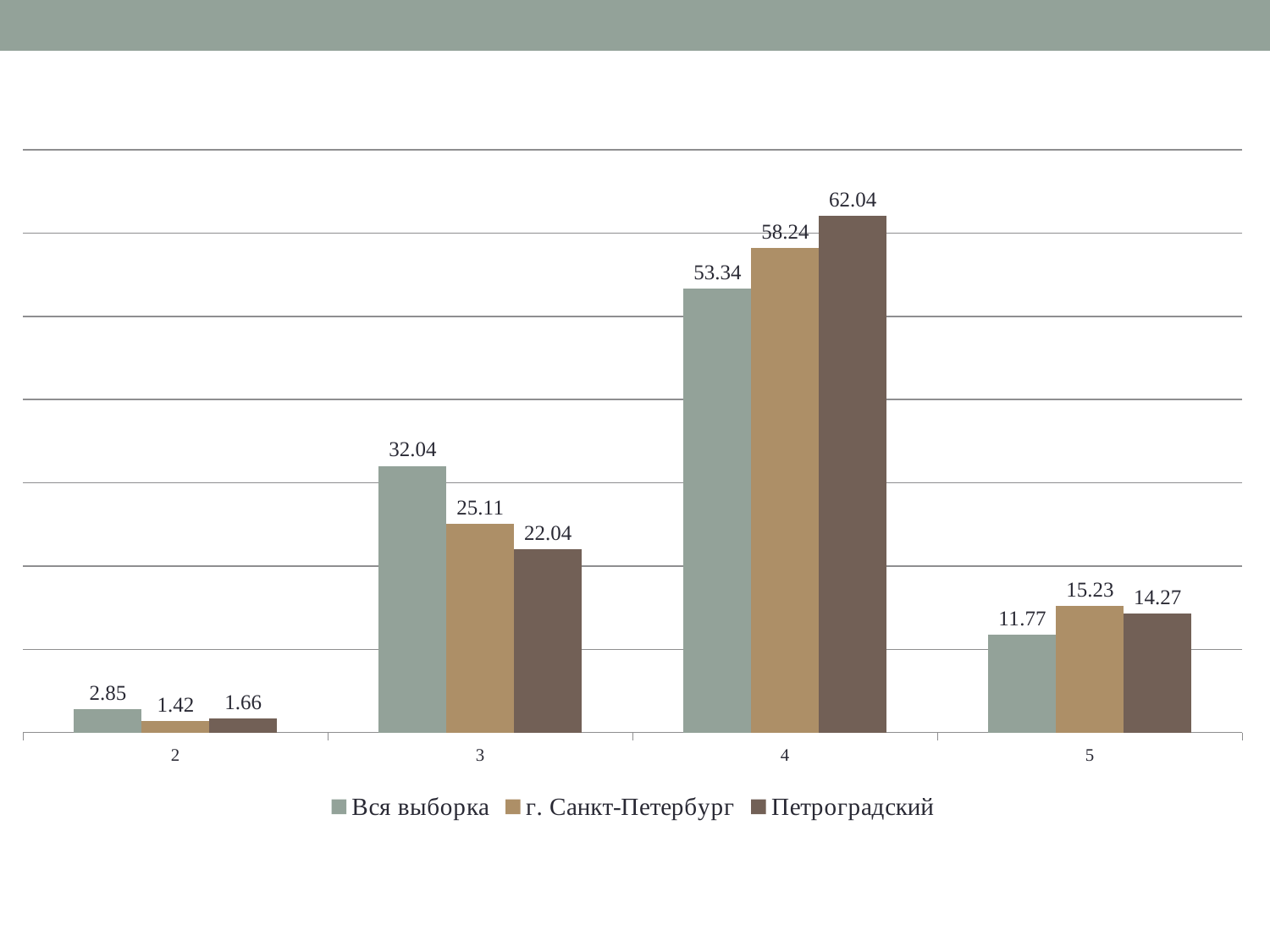
What is the difference between the "Петроградский" and "Вся выборка" values at category 4? 8.70 How many series does the legend list? 3 How many categories are shown on the x axis? 4 What is the value for "Петроградский" at category 4? 62.04 Which category has the highest value for the "Вся выборка" series? 4 What is the difference between the "Вся выборка" and "г. Санкт-Петербург" values at category 3? 6.93 Which category has the lowest value for the "Петроградский" series? 2 What kind of chart is shown on the slide? Bar chart What is the value for "г. Санкт-Петербург" at category 5? 15.23 What is the value for "Вся выборка" at category 3? 32.04 At category 3, which series has the larger value: "г. Санкт-Петербург" or "Петроградский"? г. Санкт-Петербург At category 5, which series has the larger value: "Вся выборка" or "г. Санкт-Петербург"? г. Санкт-Петербург